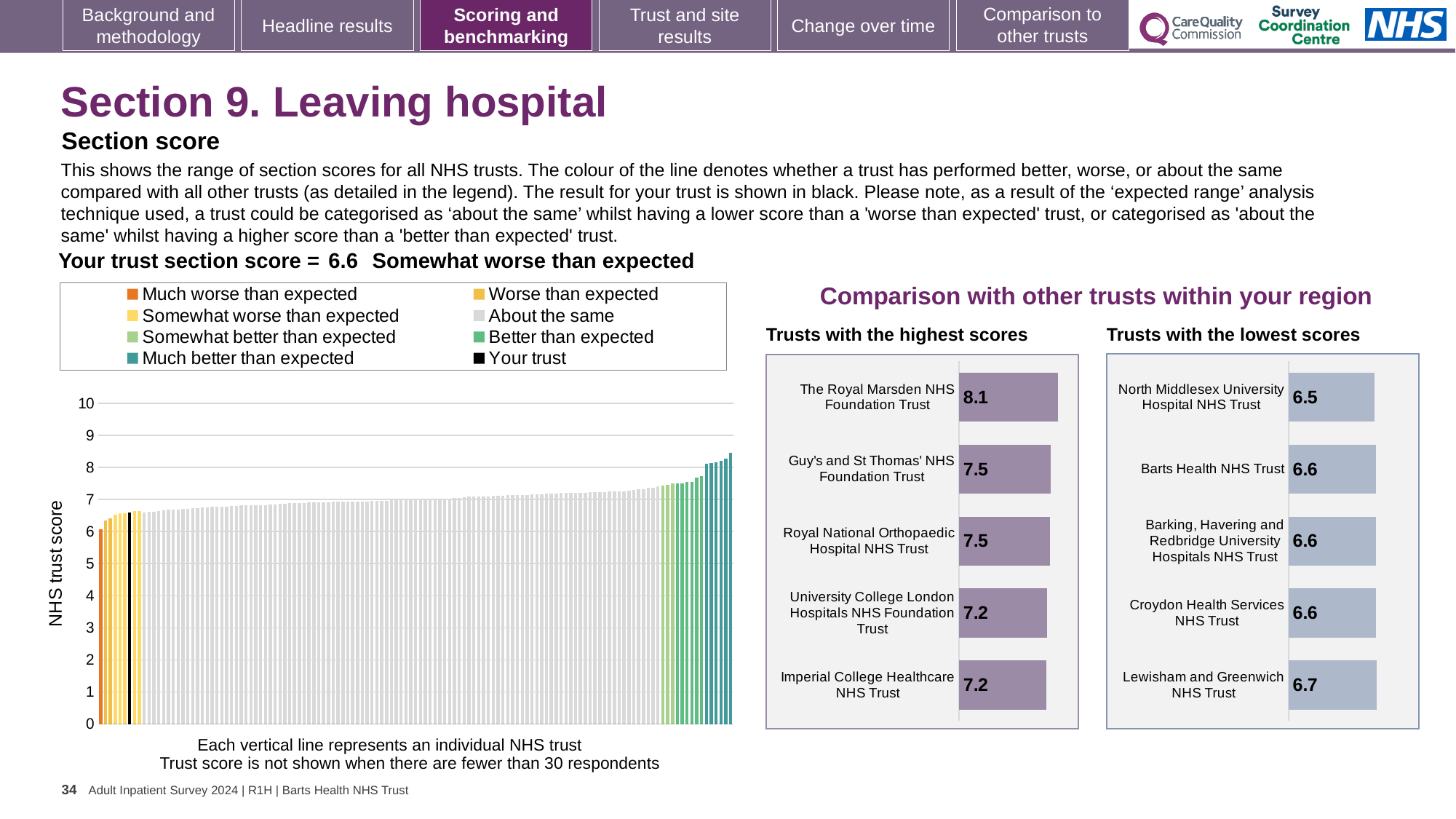
In the 'Trusts with the lowest scores' chart, what is the difference between the scores of Lewisham and Greenwich NHS Trust and North Middlesex University Hospital NHS Trust? 0.2 How many entries does the legend of the NHS trust score chart on the left list? 8 In the 'Trusts with the highest scores' chart, which trust has the highest score? The Royal Marsden NHS Foundation Trust In the 'Trusts with the lowest scores' chart, what is the score for North Middlesex University Hospital NHS Trust? 6.5 In the NHS trust score chart on the left, do the values rise or fall from left to right? Rise In the 'Trusts with the lowest scores' chart, which trust has the lowest score? North Middlesex University Hospital NHS Trust In the 'Trusts with the highest scores' chart, what is the score for The Royal Marsden NHS Foundation Trust? 8.1 In the 'Trusts with the highest scores' chart, what is the difference between the scores of The Royal Marsden NHS Foundation Trust and Imperial College Healthcare NHS Trust? 0.9 In the 'Trusts with the highest scores' chart, how many trusts are shown? 5 What kind of chart is the large chart on the left showing NHS trust scores? Bar chart In the 'Trusts with the lowest scores' chart, what is the score for Lewisham and Greenwich NHS Trust? 6.7 In the 'Trusts with the highest scores' chart, which has the larger score: Guy's and St Thomas' NHS Foundation Trust or University College London Hospitals NHS Foundation Trust? Guy's and St Thomas' NHS Foundation Trust